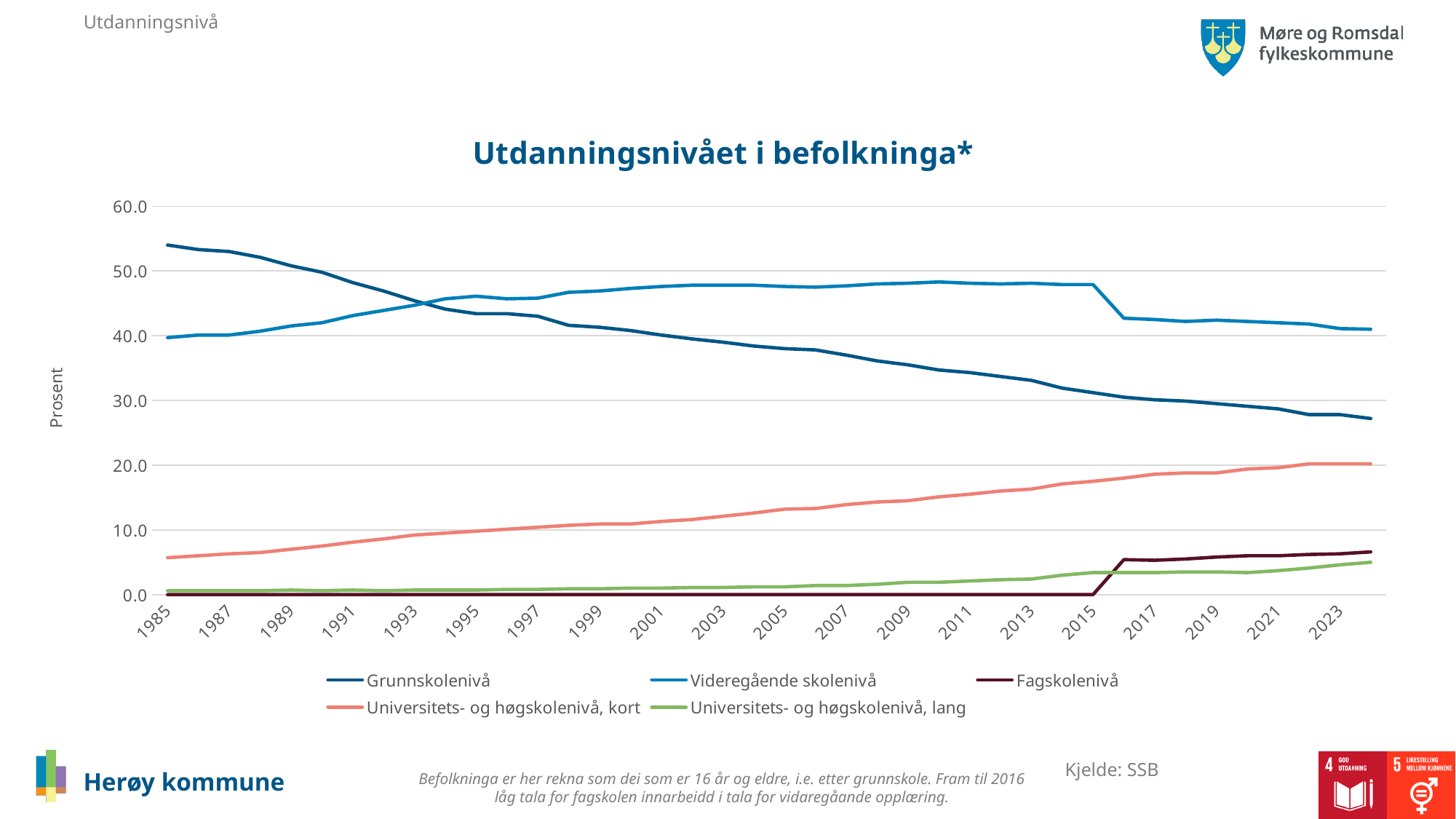
How many series does the legend list? 5 How many year labels are shown on the x axis? 20 In 2023, which is larger: Videregående skolenivå or Grunnskolenivå? Videregående skolenivå What is the title of the chart? Utdanningsnivået i befolkninga* Is the value for Fagskolenivå in 2023 greater or less than 10.0? less Does the Grunnskolenivå line rise or fall from 1985 to 2023? fall What kind of chart is shown on the slide? line chart Does the Universitets- og høgskolenivå, kort line rise or fall from 1985 to 2023? rise Which series has the highest value in 1985? Grunnskolenivå What is the label on the vertical axis? Prosent Is the value for Universitets- og høgskolenivå, kort in 1985 greater or less than 10.0? less Is the value for Grunnskolenivå in 1985 greater or less than 50.0? greater